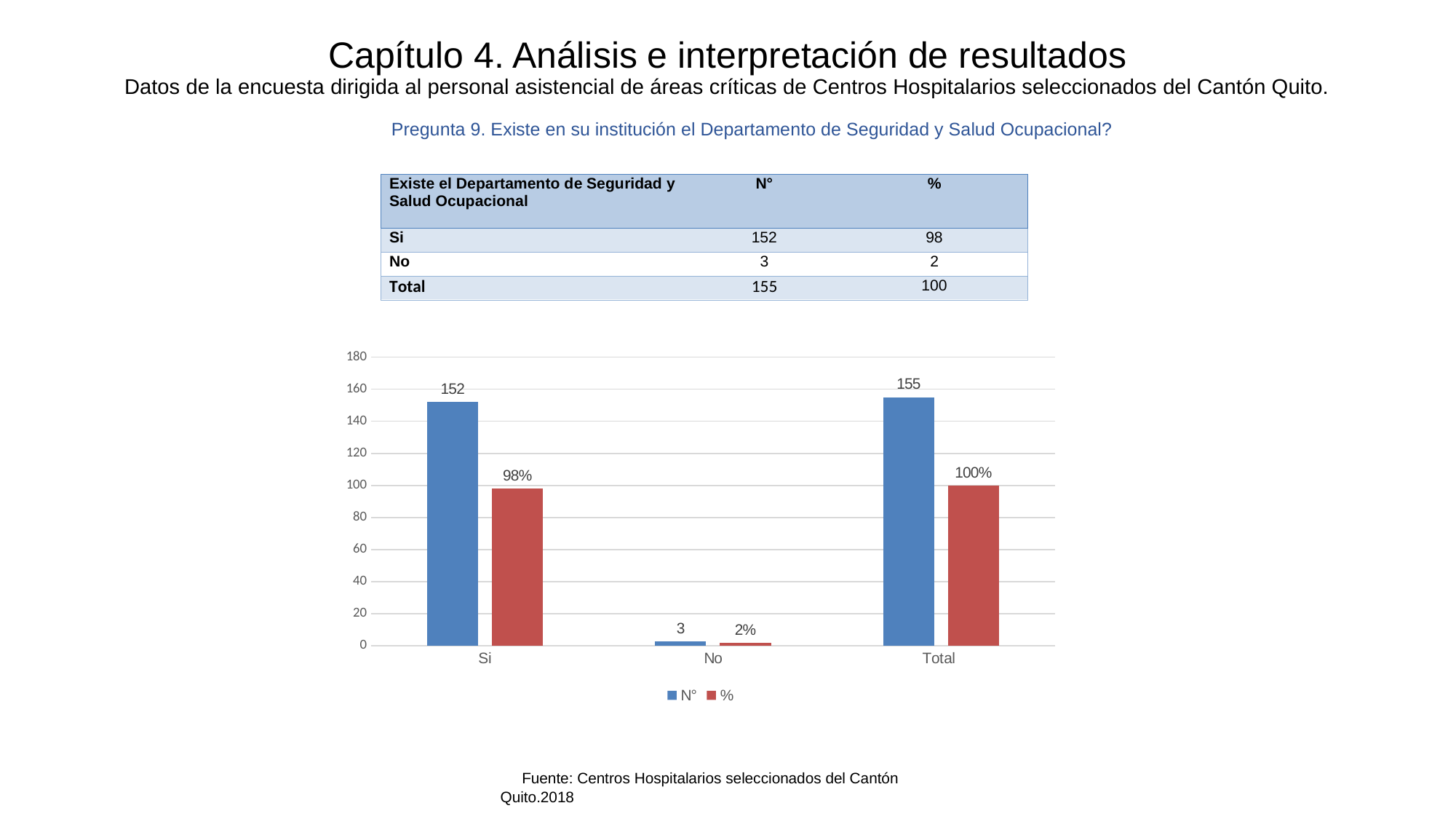
What is the % value for the Si category? 98% What is the N° value for the Total category? 155 How many series does the chart legend list? 2 How many categories are shown on the x axis of the chart? 3 Which colour represents the % series in the chart? Red What is the N° value for the Si category? 152 Which category has the lowest N° value? No Which is larger, the N° value for Si or the N° value for No? Si What is the difference between the N° values for Si and No? 149 What kind of chart is shown on the slide? Bar chart Which category has the highest N° value? Total What is the % value for the No category? 2%